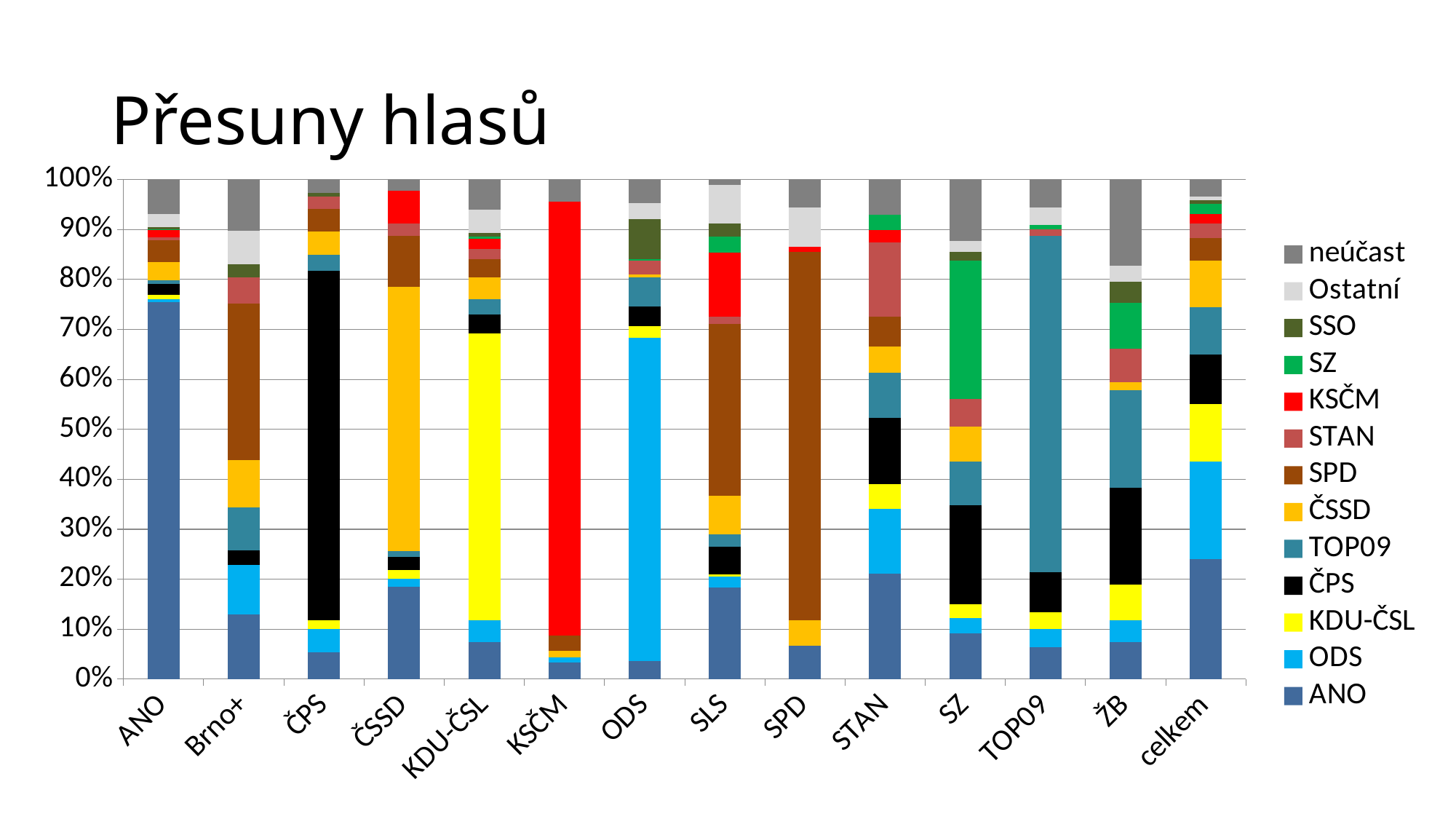
Is the KSČM share in the KSČM bar greater or less than 80%? greater Which series is shown in red in the legend? KSČM Is the SPD share in the SPD bar greater or less than 70%? greater How many categories are shown along the x axis? 14 Which bar has the largest KSČM segment? KSČM Is the ANO share in the celkem bar greater or less than 20%? greater Is the ANO segment larger in the ANO bar or in the Brno+ bar? ANO How many series does the legend list? 13 What is the title of the chart? Přesuny hlasů What kind of chart is shown on the slide? stacked bar chart